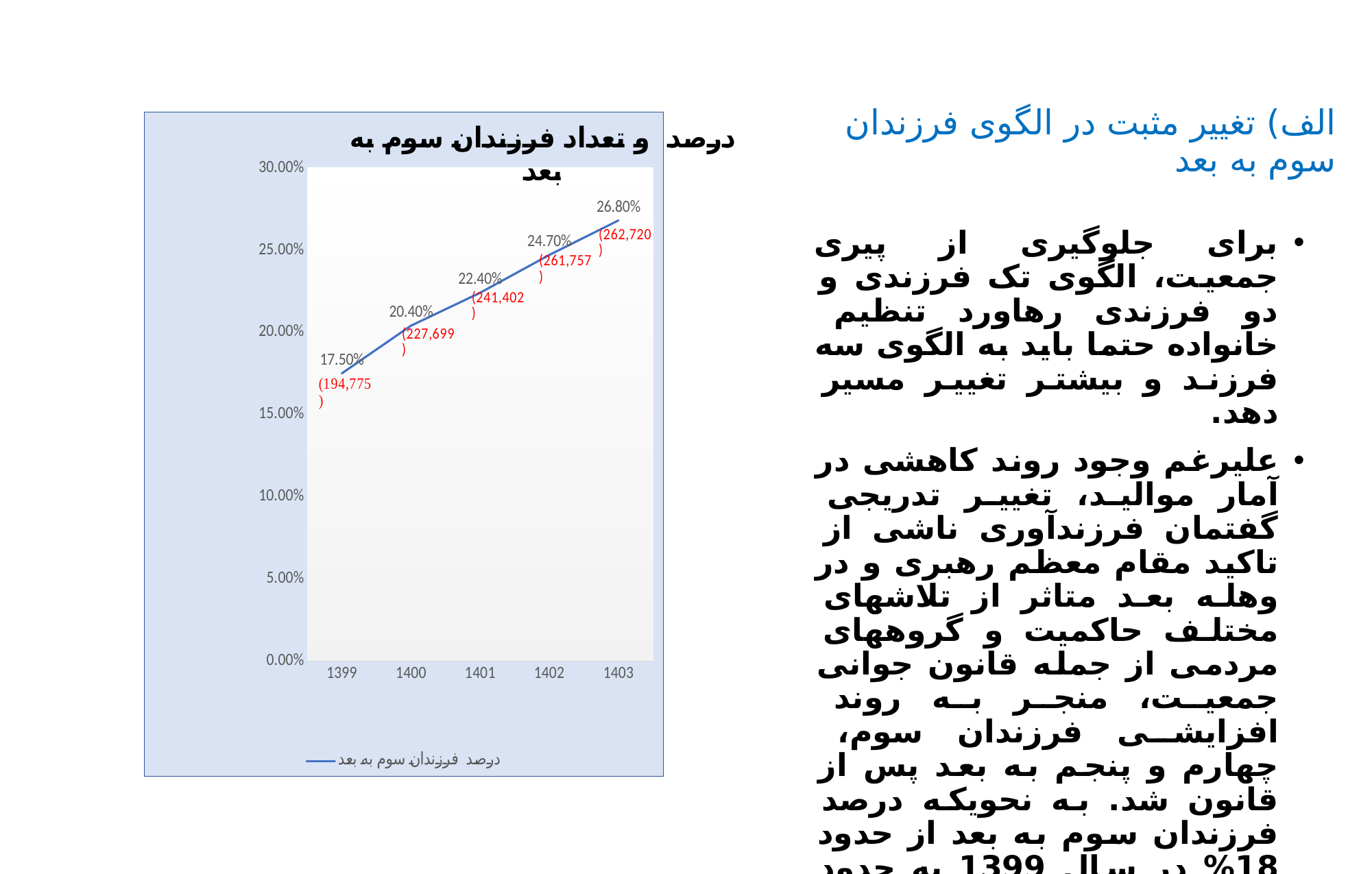
What type of chart is shown on the slide? line chart What is the percentage value for 1403? 26.80% Which year has the highest percentage value? 1403 Which year has a larger percentage value, 1400 or 1402? 1402 What is the percentage value for 1401? 22.40% How many years are plotted on the x axis? 5 Do the percentage values rise or fall from 1399 to 1403? rise What is the percentage value for 1399? 17.50% What is the count shown in red for 1402? (261,757) What is the count shown in red for 1400? (227,699) Which year has the lowest percentage value? 1399 What is the difference in percentage between 1403 and 1399? 9.30%